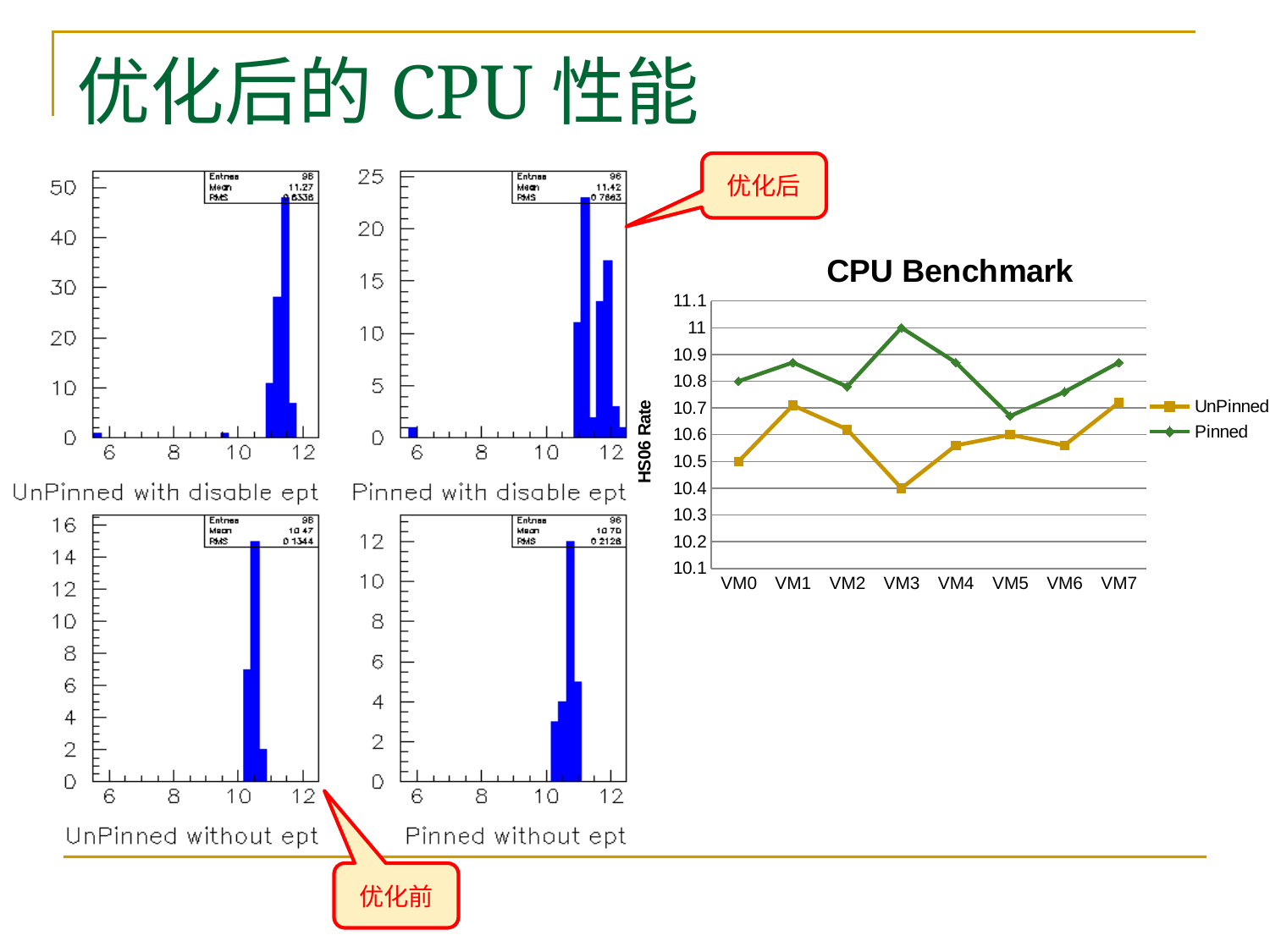
How many series does the legend of the CPU Benchmark chart list? 2 In the CPU Benchmark chart, at VM3, which series has the larger value, Pinned or UnPinned? Pinned In the CPU Benchmark chart, does the Pinned series rise or fall from VM3 to VM5? fall In the CPU Benchmark chart, what is the HS06 Rate for the UnPinned series at VM0? 10.5 In the CPU Benchmark chart, is the UnPinned value at VM1 greater or less than 10.6? greater How many VMs are shown on the x axis of the CPU Benchmark chart? 8 In the CPU Benchmark chart, which VM has the highest value for the Pinned series? VM3 In the CPU Benchmark chart, what is the HS06 Rate for the Pinned series at VM3? 11 In the CPU Benchmark chart, is the Pinned value at VM4 greater or less than 10.8? greater What kind of chart is the CPU Benchmark chart? line chart In the CPU Benchmark chart, what is the HS06 Rate for the UnPinned series at VM3? 10.4 In the CPU Benchmark chart, which VM has the lowest value for the UnPinned series? VM3